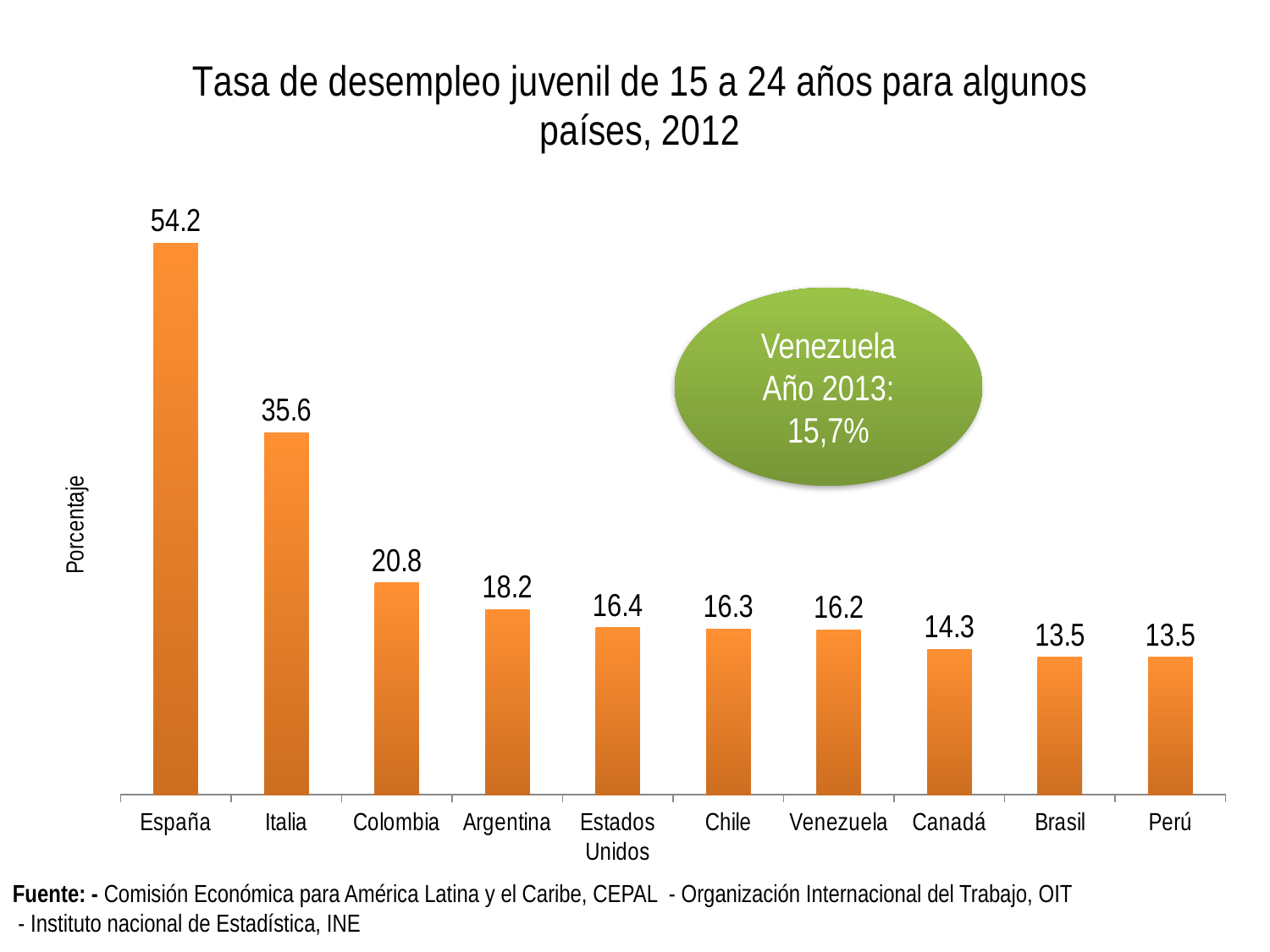
What is the difference between the values for España and Italia? 18.6 Which country has the highest youth unemployment rate in the chart? España What is the value shown for Colombia? 20.8 What type of chart is shown on the slide? Bar chart How many countries are shown in the chart? 10 What is the label on the vertical axis of the chart? Porcentaje Which has a higher value, Argentina or Chile? Argentina What is the difference between the values for Colombia and Canadá? 6.5 Do the values rise or fall from left to right across the countries? Fall What is the value shown for Venezuela in the bar chart? 16.2 What is the youth unemployment rate shown for España? 54.2 Which countries share the lowest value in the chart? Brasil and Perú